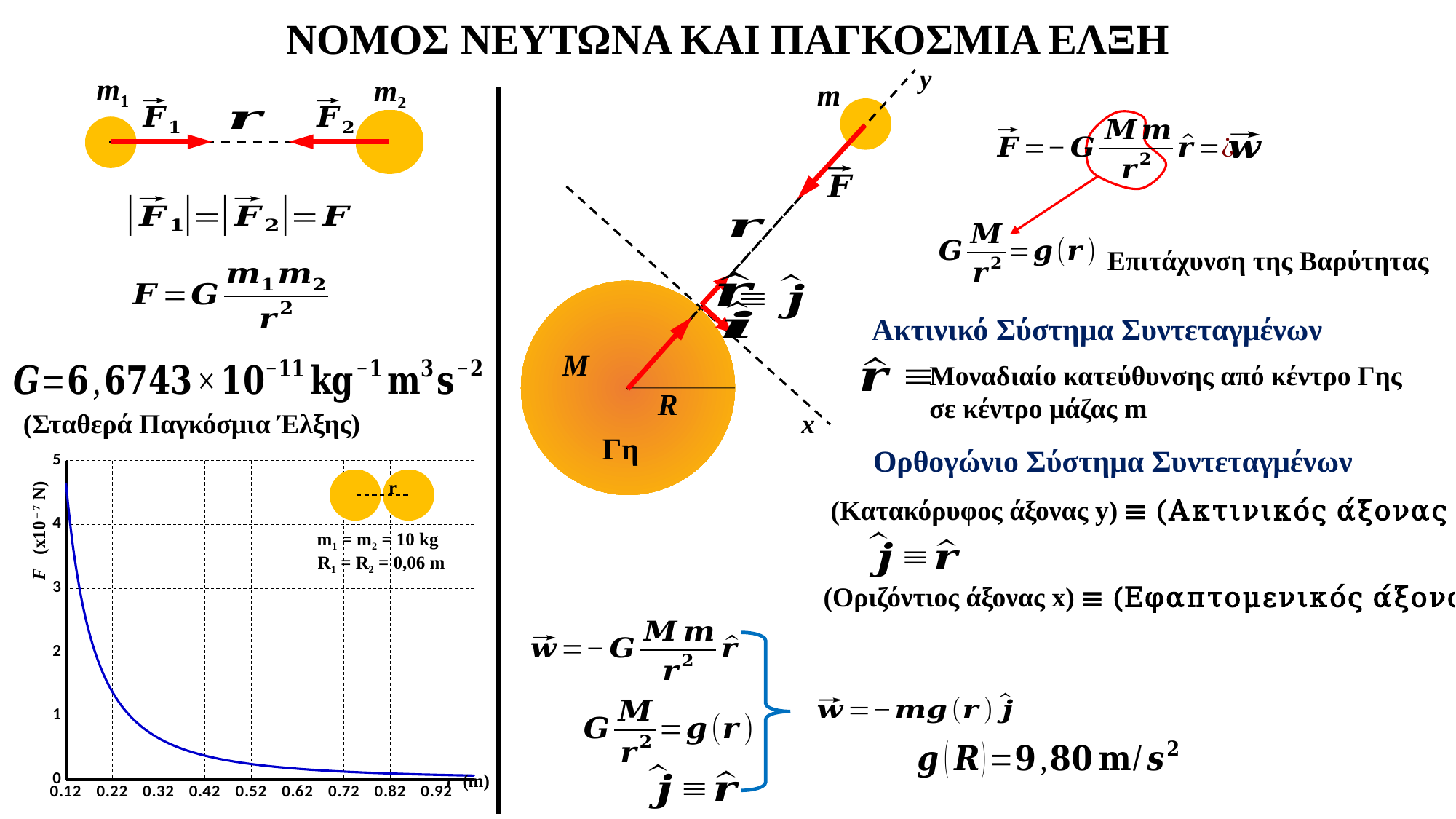
How many lines are plotted in the bottom-left chart? 1 In the bottom-left chart, is the value of F at r = 0.92 m greater or less than 1? less In the bottom-left chart, is the value of F at r = 0.12 m greater or less than 4? greater In the bottom-left chart, what is the first value labelled on the x axis? 0.12 In the bottom-left chart, is the value of F at r = 0.32 m greater or less than 1? less In the bottom-left chart, what is the highest value labelled on the y axis? 5 How many tick labels are shown on the x axis of the bottom-left chart? 9 In the bottom-left chart, does F rise or fall as r increases along the x axis? fall In the bottom-left chart, which is larger: F at r = 0.22 m or F at r = 0.52 m? F at r = 0.22 m What kind of chart is shown at the bottom left of the slide? line chart